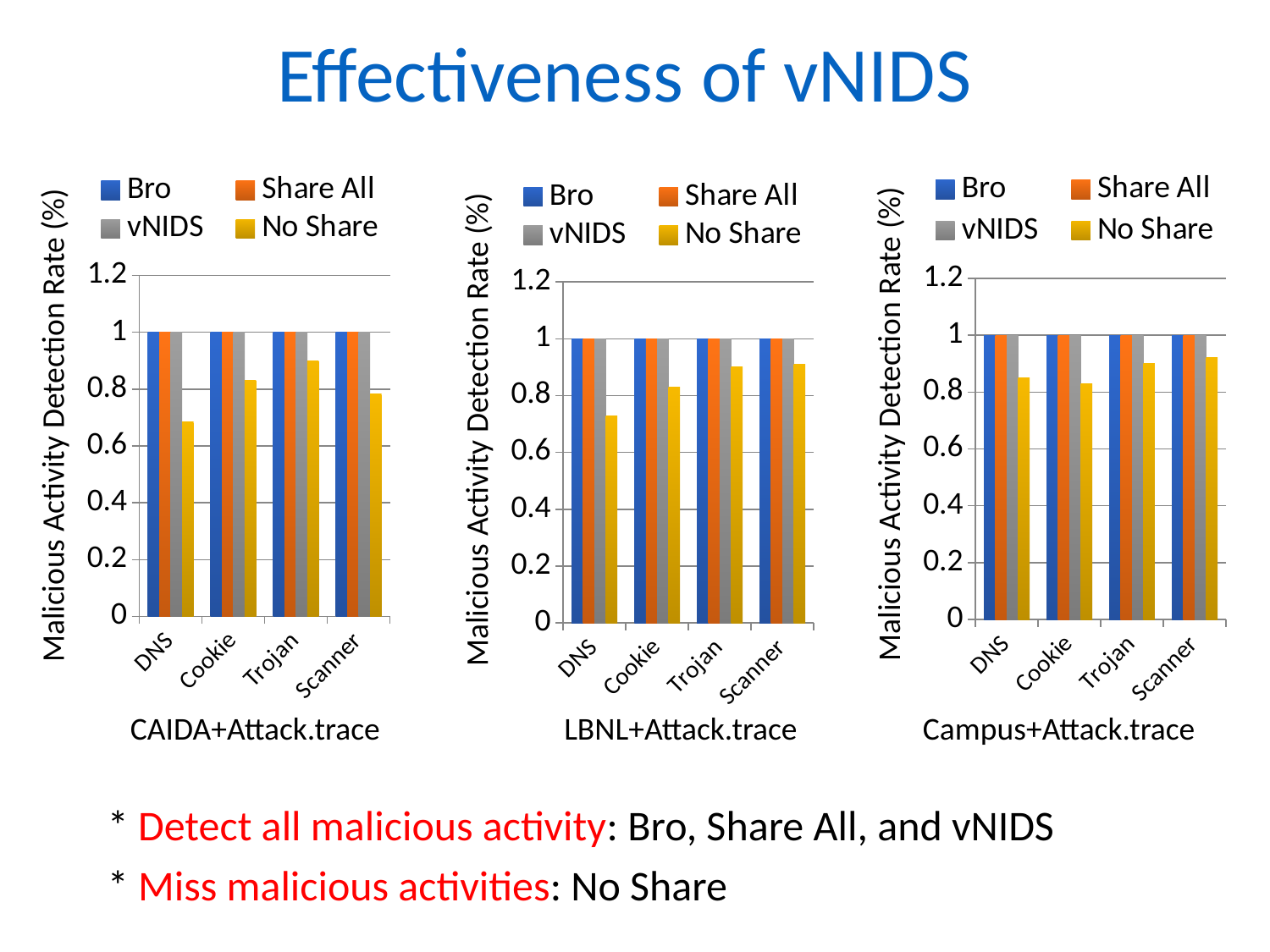
In the CAIDA+Attack.trace chart, how many series does the legend list? 4 In the CAIDA+Attack.trace chart, what kind of chart is shown? bar chart In the CAIDA+Attack.trace chart, is the value for No Share on DNS greater or less than 0.8? less In the LBNL+Attack.trace chart, is the value for No Share on Scanner greater or less than 0.8? greater In the CAIDA+Attack.trace chart, what is the value for Bro on DNS? 1 In the LBNL+Attack.trace chart, which is larger for No Share: DNS or Trojan? Trojan In the CAIDA+Attack.trace chart, which category has the lowest No Share value? DNS In the Campus+Attack.trace chart, which is larger on Cookie: Share All or No Share? Share All In the LBNL+Attack.trace chart, how many categories are shown on the x axis? 4 In the LBNL+Attack.trace chart, what is the y-axis label? Malicious Activity Detection Rate (%) In the Campus+Attack.trace chart, what is the value for vNIDS on Scanner? 1 In the Campus+Attack.trace chart, is the value for No Share on Cookie greater or less than 1? less